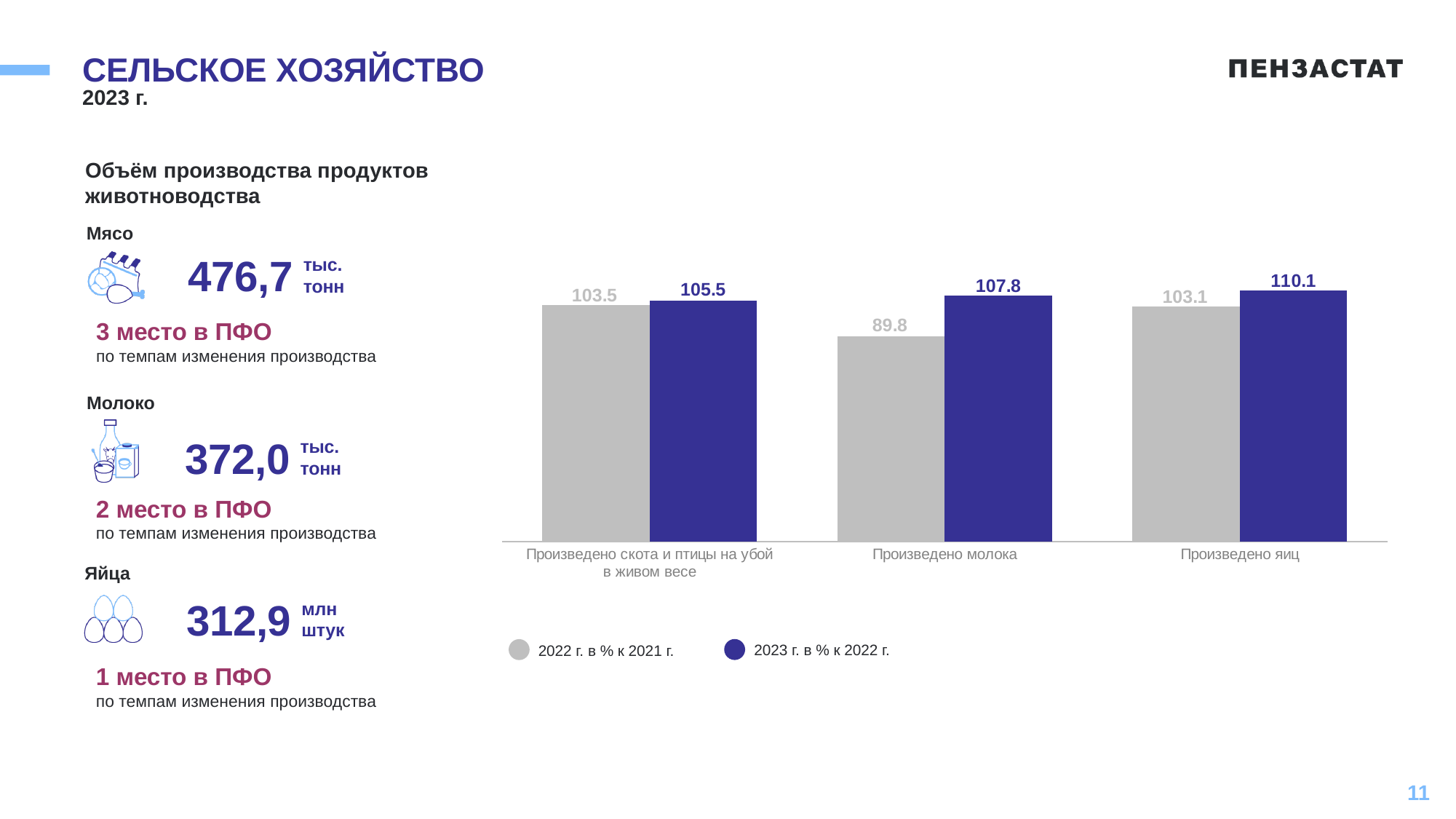
What colour are the bars for the '2023 г. в % к 2022 г.' series? dark blue What is the difference between the 2023 and 2022 values for 'Произведено молока'? 18.0 What is the value for 'Произведено яиц' in the '2023 г. в % к 2022 г.' series? 110.1 How many categories are shown on the x axis of the chart? 3 Which category has the lowest value in the '2022 г. в % к 2021 г.' series? Произведено молока What is the value for 'Произведено скота и птицы на убой в живом весе' in the '2022 г. в % к 2021 г.' series? 103.5 Which is larger for 'Произведено скота и птицы на убой в живом весе': the 2022 value or the 2023 value? 2023 г. в % к 2022 г. How many series does the chart legend list? 2 Which category has the highest value in the '2023 г. в % к 2022 г.' series? Произведено яиц What is the difference between the 2023 and 2022 values for 'Произведено яиц'? 7.0 What kind of chart is shown on the slide? bar chart What is the value for 'Произведено молока' in the '2022 г. в % к 2021 г.' series? 89.8